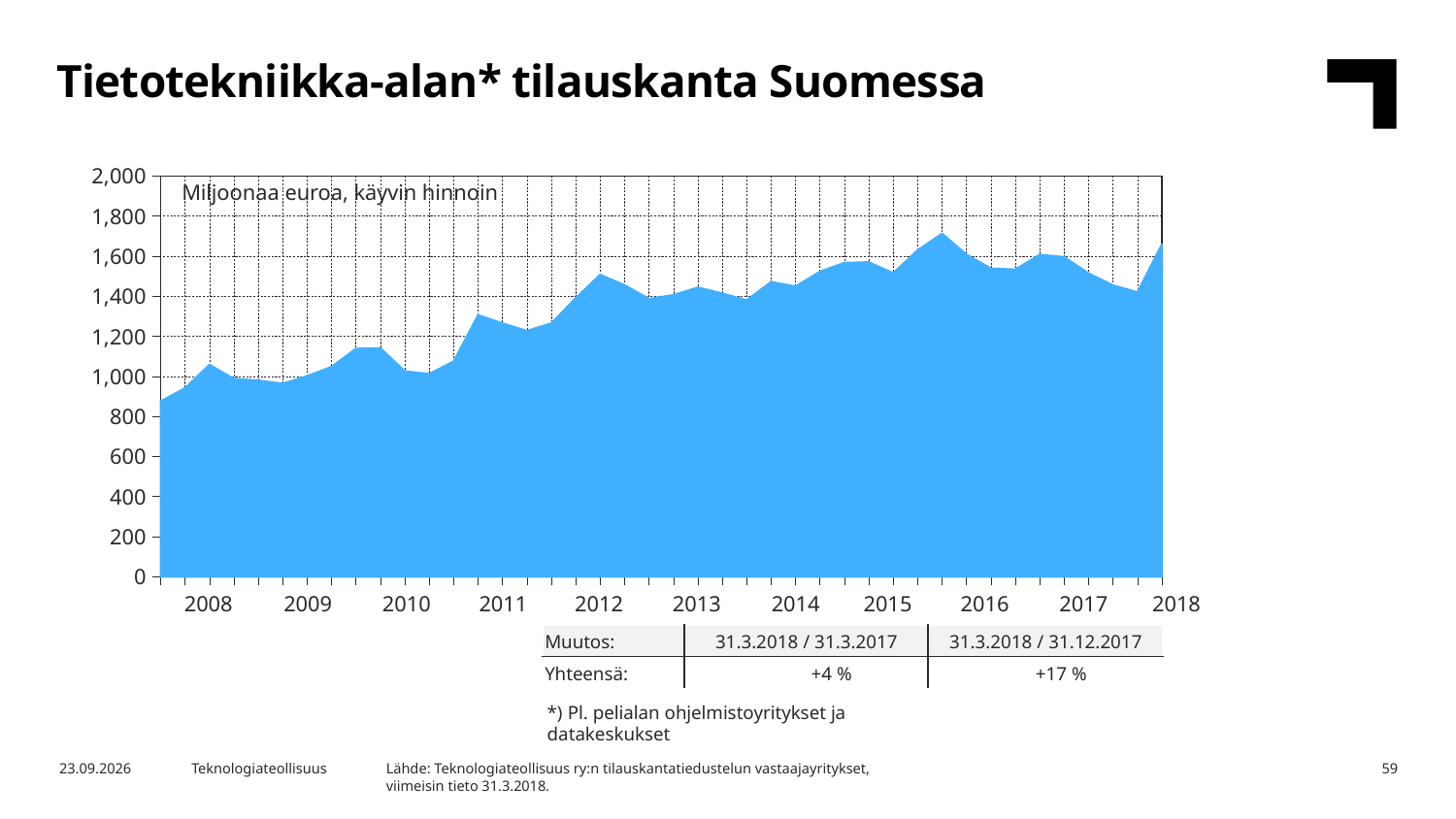
Is the value at 2018 greater or less than 1,400? greater Overall, do the values rise or fall from 2008 to 2018? Rise What unit is stated inside the chart area? Miljoonaa euroa, käyvin hinnoin What is the change (Muutos) for 31.3.2018 / 31.12.2017 shown in the table below the chart? +17 % What is the change (Muutos) for 31.3.2018 / 31.3.2017 shown in the table below the chart? +4 % Is the highest point of the series greater or less than 1,600? greater Is the value at the start of 2010 greater or less than 1,200? less What is the title of the slide's chart? Tietotekniikka-alan* tilauskanta Suomessa How many year labels are shown on the x axis? 11 What kind of chart is shown on the slide? Area chart